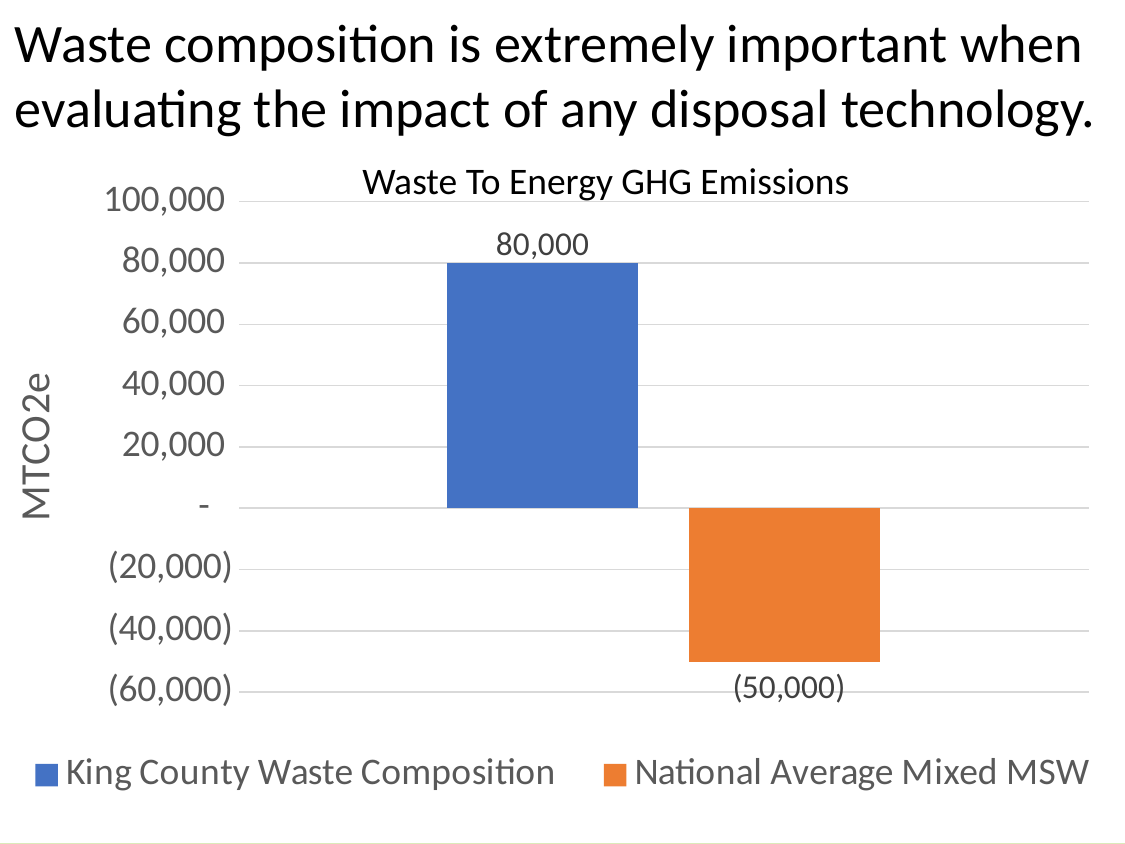
What is the value for King County Waste Composition? 80,000 What is the title of the chart? Waste To Energy GHG Emissions Is the value for King County Waste Composition greater or less than 60,000? greater Which series has the lowest value? National Average Mixed MSW What kind of chart is shown? bar chart Which is larger, the value for King County Waste Composition or the value for National Average Mixed MSW? King County Waste Composition What is the value for National Average Mixed MSW? (50,000) Is the value for National Average Mixed MSW greater or less than (20,000)? less What is the label on the vertical axis? MTCO2e What is the difference between the King County Waste Composition value and the National Average Mixed MSW value? 130,000 Which series has the highest value? King County Waste Composition How many series does the legend list? 2